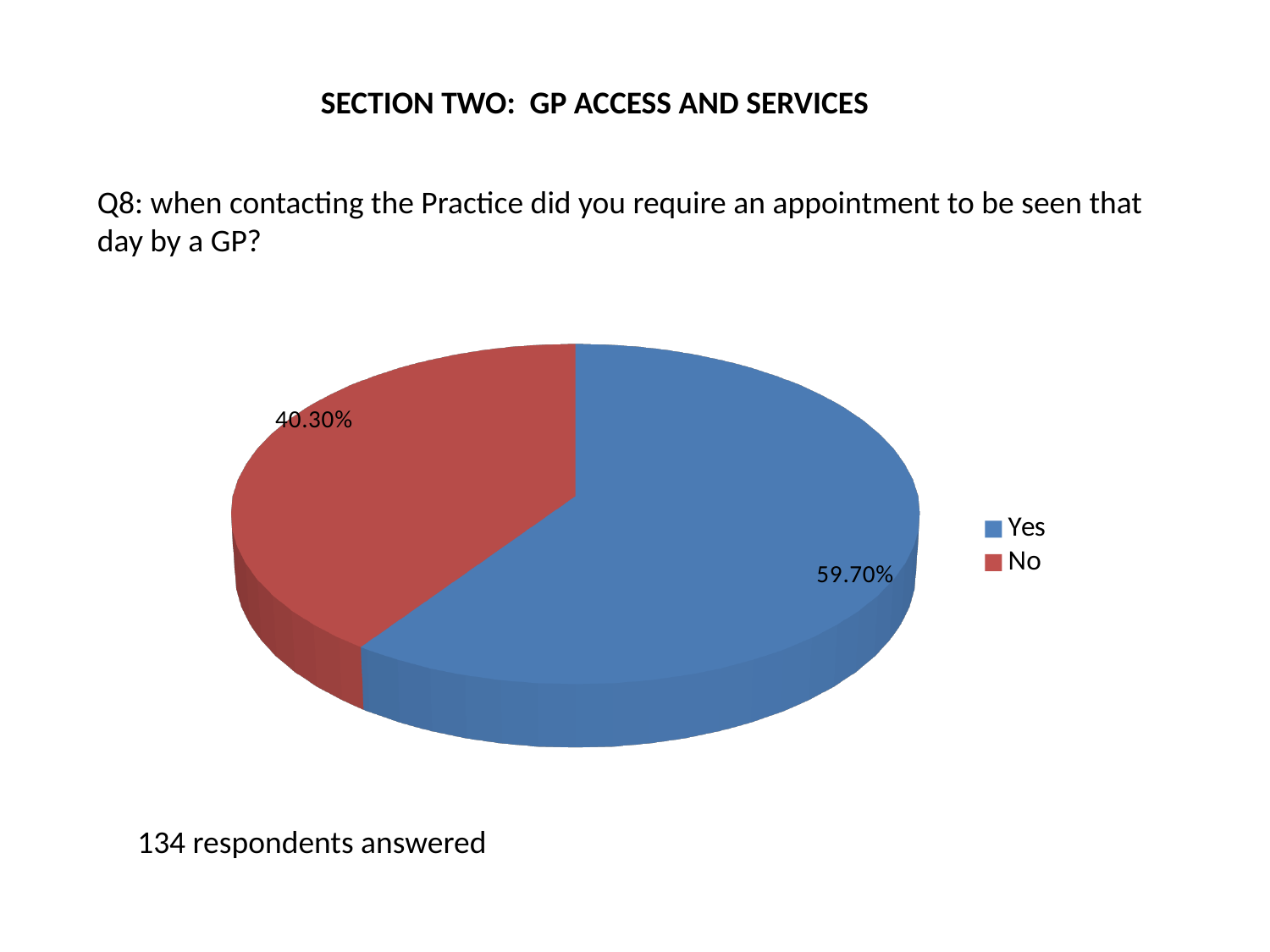
What percentage of respondents answered Yes? 59.70% What colour is the Yes slice? Blue What percentage of respondents answered No? 40.30% How many slices does the pie chart have? 2 What is the difference in percentage points between the Yes and No shares? 19.40% Which response has the smallest share of the pie? No Which response has the largest share of the pie? Yes How many respondents answered the question shown on the slide? 134 Which is larger, the share for Yes or the share for No? Yes How many entries does the legend list? 2 What kind of chart is shown on the slide? Pie chart Is the share for Yes greater or less than 50%? greater